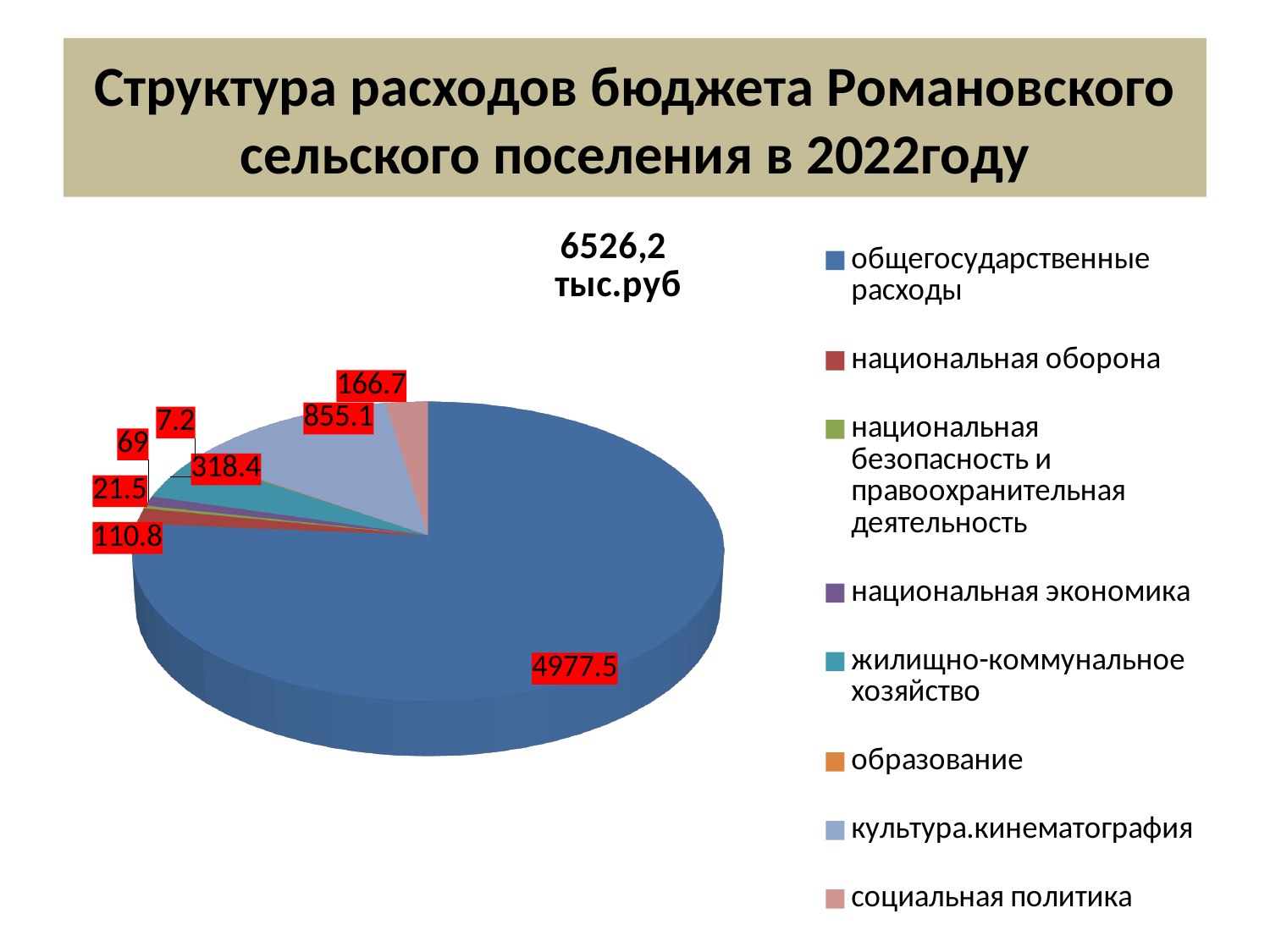
What is the smallest value labelled on the pie? 7.2 What is the value for социальная политика? 166.7 What total is shown in the chart title? 6526,2 тыс.руб What is the difference between культура.кинематография and жилищно-коммунальное хозяйство? 536.7 Which is larger, социальная политика or жилищно-коммунальное хозяйство? жилищно-коммунальное хозяйство What kind of chart is shown on the slide? pie chart What is the value for жилищно-коммунальное хозяйство? 318.4 What is the value for общегосударственные расходы? 4977.5 Which category has the largest slice of the pie? общегосударственные расходы What is the value for культура.кинематография? 855.1 How many categories does the legend list? 8 What is the value for национальная оборона? 110.8